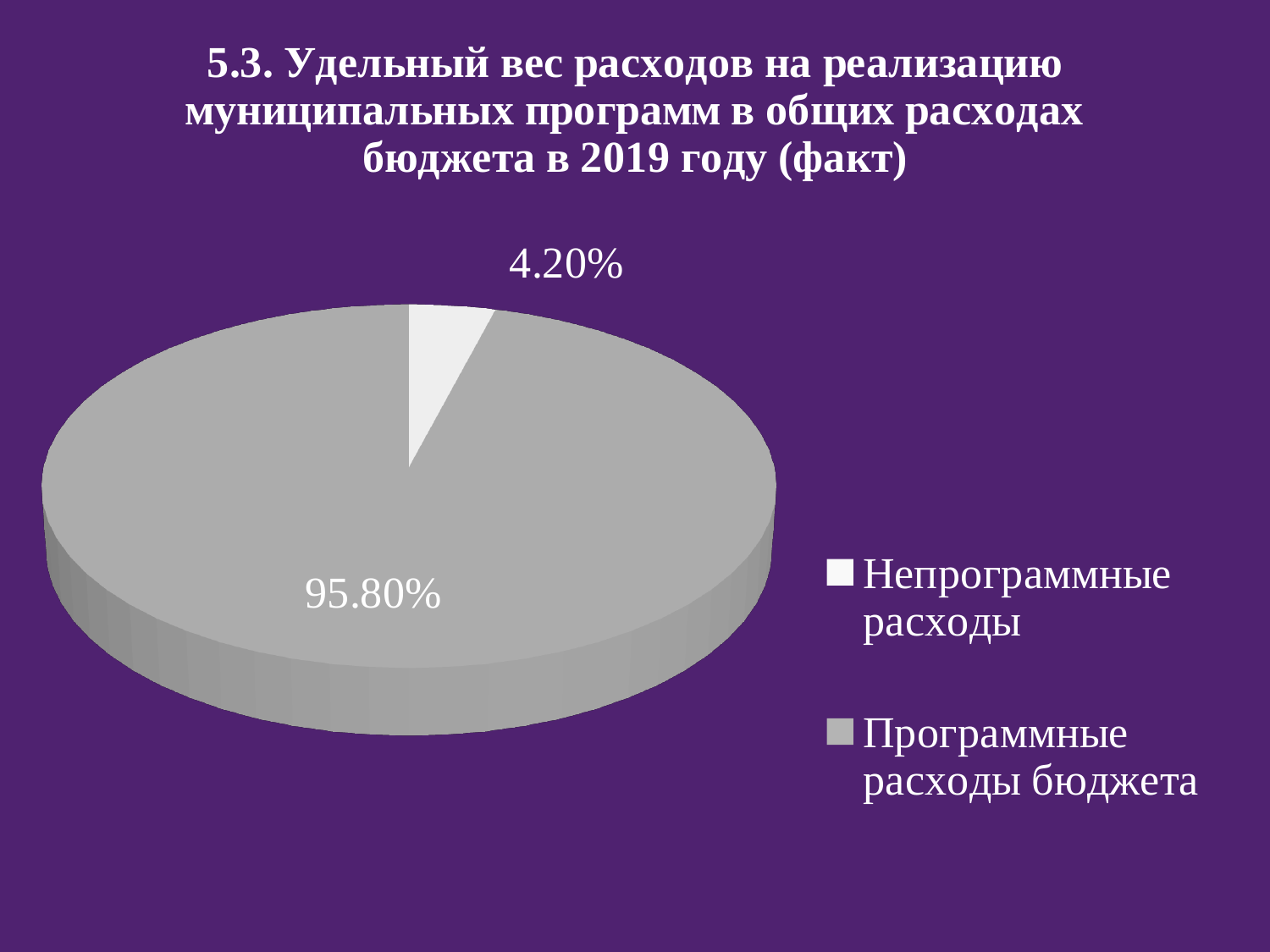
Which is larger: Непрограммные расходы or Программные расходы бюджета? Программные расходы бюджета What is the total of the two slices shown? 100.00% Which legend entry is shown in white? Непрограммные расходы What kind of chart is shown on the slide? pie chart How many entries does the legend list? 2 What is the difference between the shares of Программные расходы бюджета and Непрограммные расходы? 91.60% What is the value for Программные расходы бюджета? 95.80% Which year does the chart title refer to? 2019 What is the value for Непрограммные расходы? 4.20% Which category has the largest share of the pie? Программные расходы бюджета How many slices does the pie chart have? 2 Which category has the smallest share of the pie? Непрограммные расходы